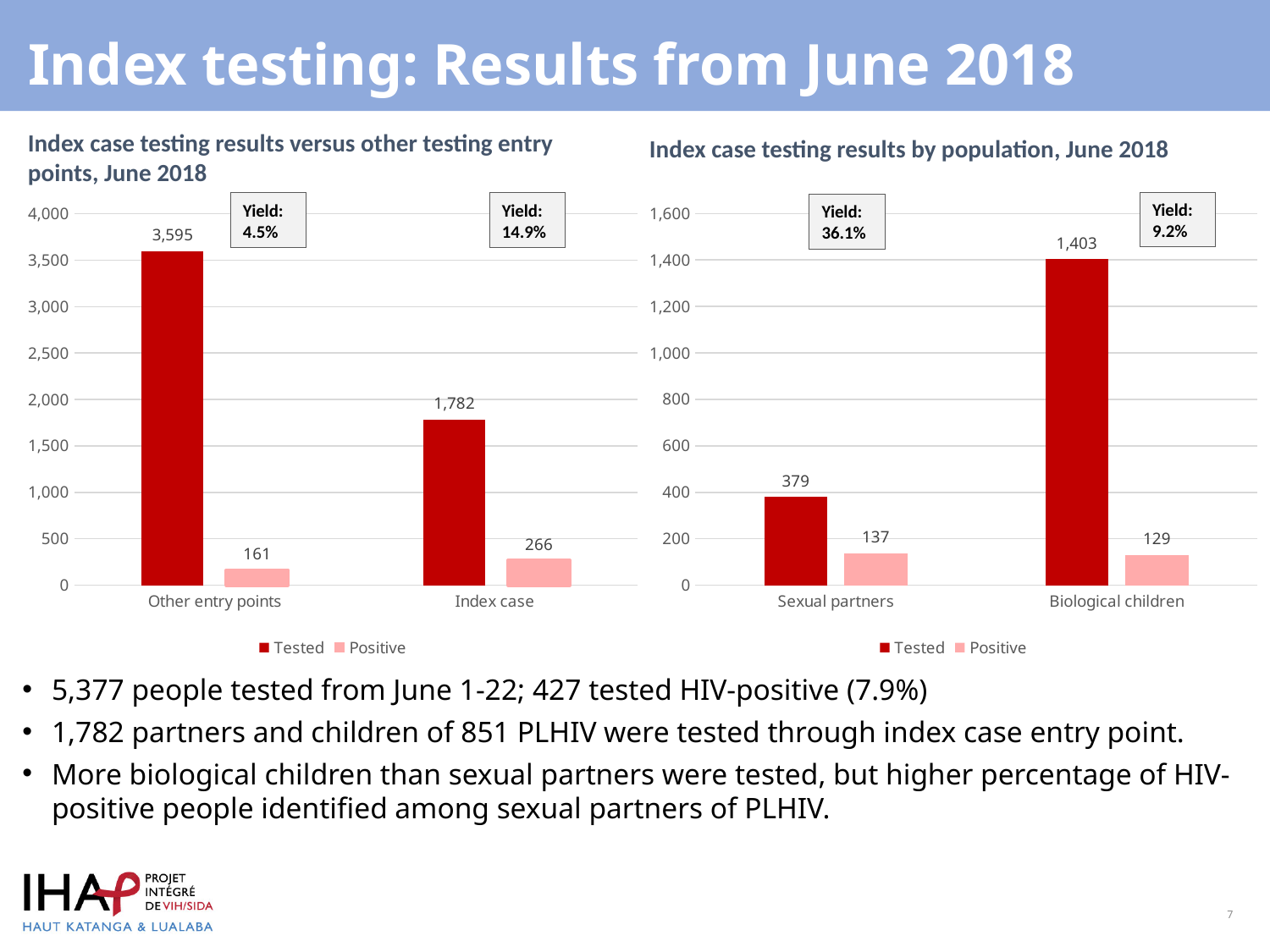
In the chart 'Index case testing results versus other testing entry points, June 2018', what is the difference between the number tested at other entry points and the number tested through index case? 1,813 In the chart 'Index case testing results versus other testing entry points, June 2018', how many positive results were there for the index case entry point? 266 In the chart 'Index case testing results by population, June 2018', which population had the highest number tested? Biological children In the chart 'Index case testing results by population, June 2018', what yield is shown for sexual partners? 36.1% In the chart 'Index case testing results versus other testing entry points, June 2018', what yield is shown for the index case entry point? 14.9% What kind of chart is 'Index case testing results by population, June 2018'? Bar chart In the chart 'Index case testing results versus other testing entry points, June 2018', which entry point has the higher number of positive results? Index case In the chart 'Index case testing results by population, June 2018', how many sexual partners were tested? 379 In the chart 'Index case testing results by population, June 2018', what is the difference between the number of biological children tested and the number of sexual partners tested? 1,024 In the chart 'Index case testing results by population, June 2018', how many series does the legend list? 2 In the chart 'Index case testing results versus other testing entry points, June 2018', how many people were tested at other entry points? 3,595 In the chart 'Index case testing results by population, June 2018', how many biological children tested positive? 129